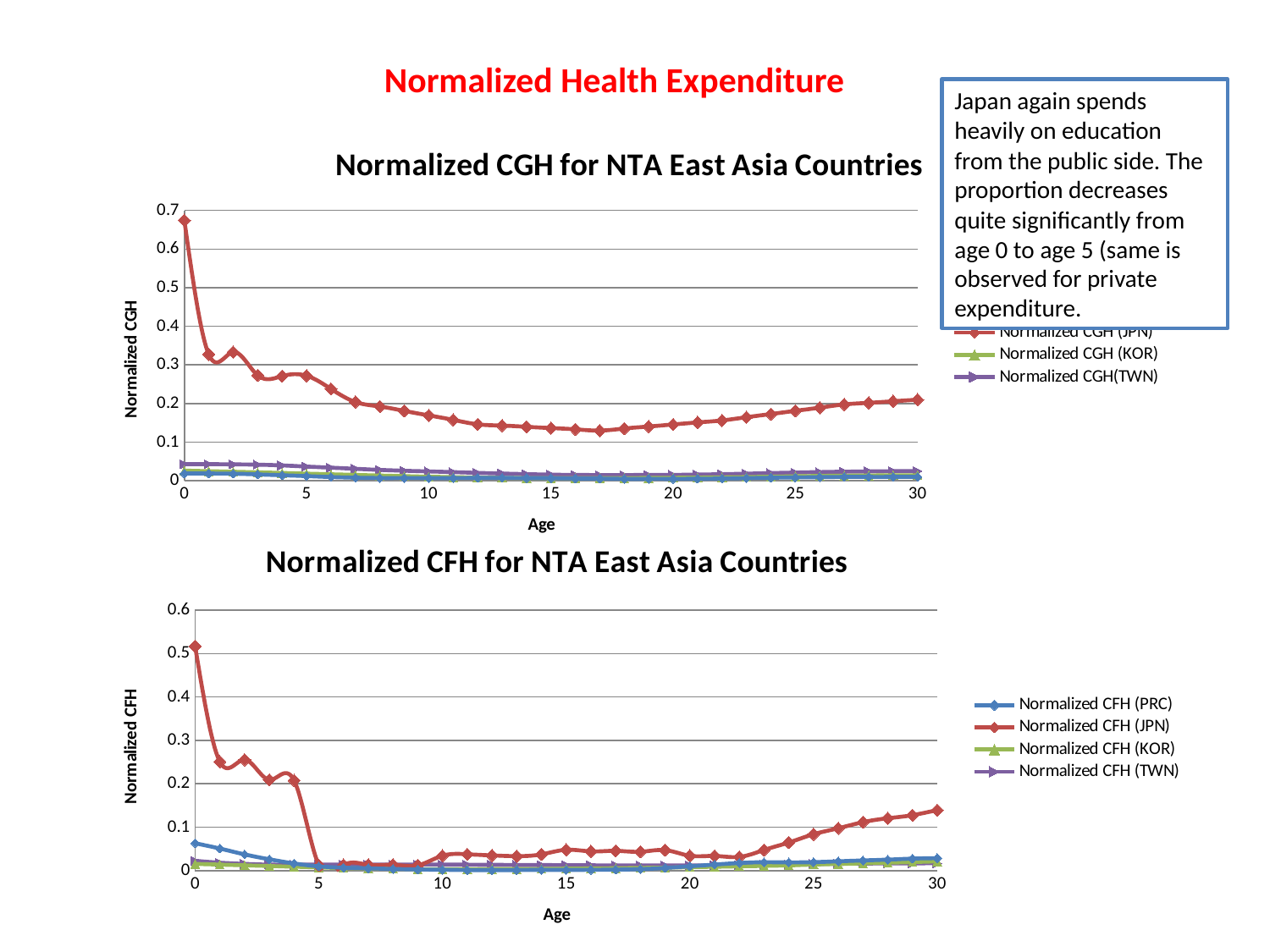
In the 'Normalized CFH for NTA East Asia Countries' chart, does the Normalized CFH (JPN) series rise or fall from age 20 to age 30? rise In the 'Normalized CGH for NTA East Asia Countries' chart, is the value for Normalized CGH (JPN) at age 15 greater or less than 0.2? less In the 'Normalized CGH for NTA East Asia Countries' chart, does the Normalized CGH (JPN) series rise or fall from age 0 to age 5? fall In the 'Normalized CFH for NTA East Asia Countries' chart, is the value for Normalized CFH (JPN) at age 30 greater or less than 0.1? greater How many series does the legend of the 'Normalized CFH for NTA East Asia Countries' chart list? 4 What is the x-axis label of the 'Normalized CFH for NTA East Asia Countries' chart? Age What kind of chart is the 'Normalized CGH for NTA East Asia Countries' chart? line chart In the 'Normalized CFH for NTA East Asia Countries' chart, which is larger at age 0: Normalized CFH (JPN) or Normalized CFH (KOR)? Normalized CFH (JPN) What is the title of the top chart on the slide? Normalized CGH for NTA East Asia Countries In the 'Normalized CFH for NTA East Asia Countries' chart, is the value for Normalized CFH (JPN) at age 0 greater or less than 0.5? greater In the 'Normalized CGH for NTA East Asia Countries' chart, which series has the highest value at age 0? Normalized CGH (JPN)